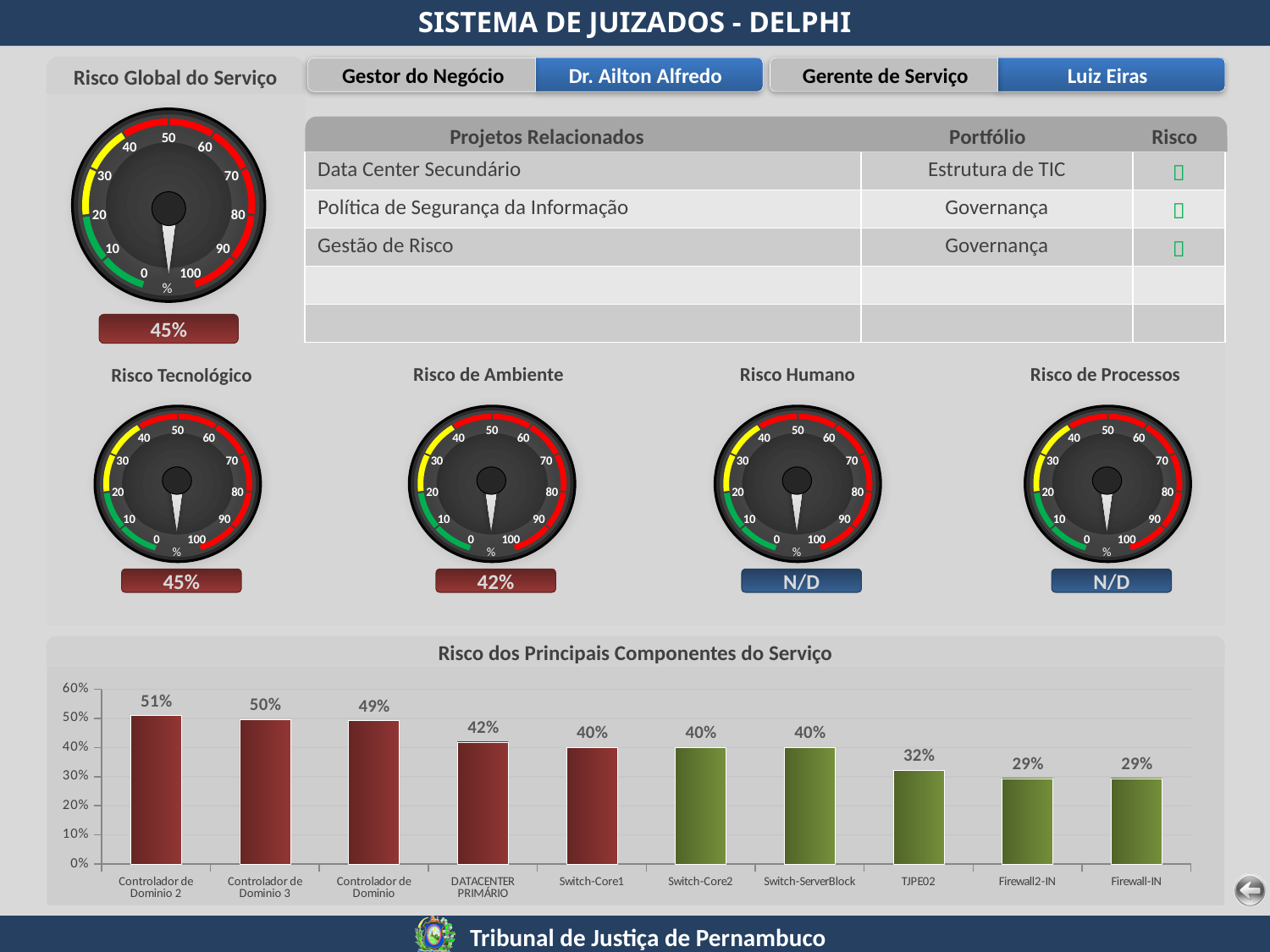
In the chart 'Risco dos Principais Componentes do Serviço', what is the difference between Controlador de Dominio 2 and Firewall-IN? 22% In the chart 'Risco dos Principais Componentes do Serviço', what is the value for DATACENTER PRIMÁRIO? 42% What value is shown below the 'Risco de Ambiente' gauge? 42% In the chart 'Risco dos Principais Componentes do Serviço', is the value for Controlador de Dominio 3 greater or less than 40%? greater In the chart 'Risco dos Principais Componentes do Serviço', what is the value for Controlador de Dominio 2? 51% What value is shown below the 'Risco Global do Serviço' gauge? 45% In the chart 'Risco dos Principais Componentes do Serviço', which component has the highest value? Controlador de Dominio 2 In the chart 'Risco dos Principais Componentes do Serviço', what is the value for TJPE02? 32% What kind of chart is 'Risco dos Principais Componentes do Serviço'? bar chart In the chart 'Risco dos Principais Componentes do Serviço', which is larger, the value for Switch-Core1 or the value for TJPE02? Switch-Core1 In the chart 'Risco dos Principais Componentes do Serviço', do the values rise or fall from left to right? fall How many components are shown in the chart 'Risco dos Principais Componentes do Serviço'? 10